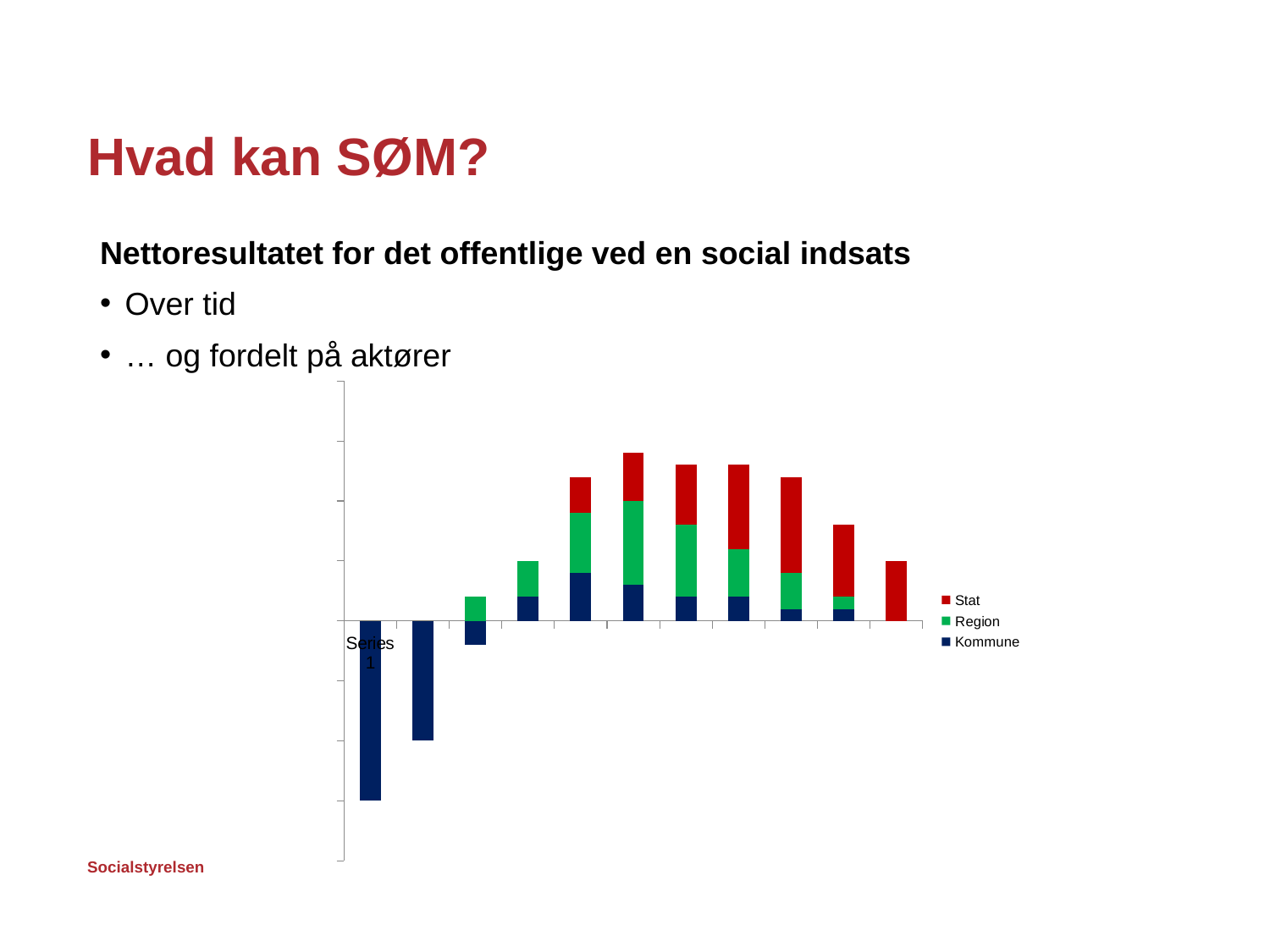
Which series are listed in the chart legend? Stat, Region, Kommune What kind of chart is shown on the slide? Stacked bar chart Which is more negative, the first bar or the second bar from the left? The first bar Which series is the only one present in the rightmost bar? Stat Which colour represents the Kommune series in the chart? Dark blue Do the bar totals rise or fall across the last four bars on the right? Fall How many series does the legend list? 3 Which bar has the lowest (most negative) value in the chart? The first bar from the left How many bars are plotted in the chart? 11 Which bar reaches the highest positive total in the chart? The sixth bar from the left Which series is the only one present in the first two bars from the left? Kommune Do the bar totals rise or fall across the first five bars from the left? Rise